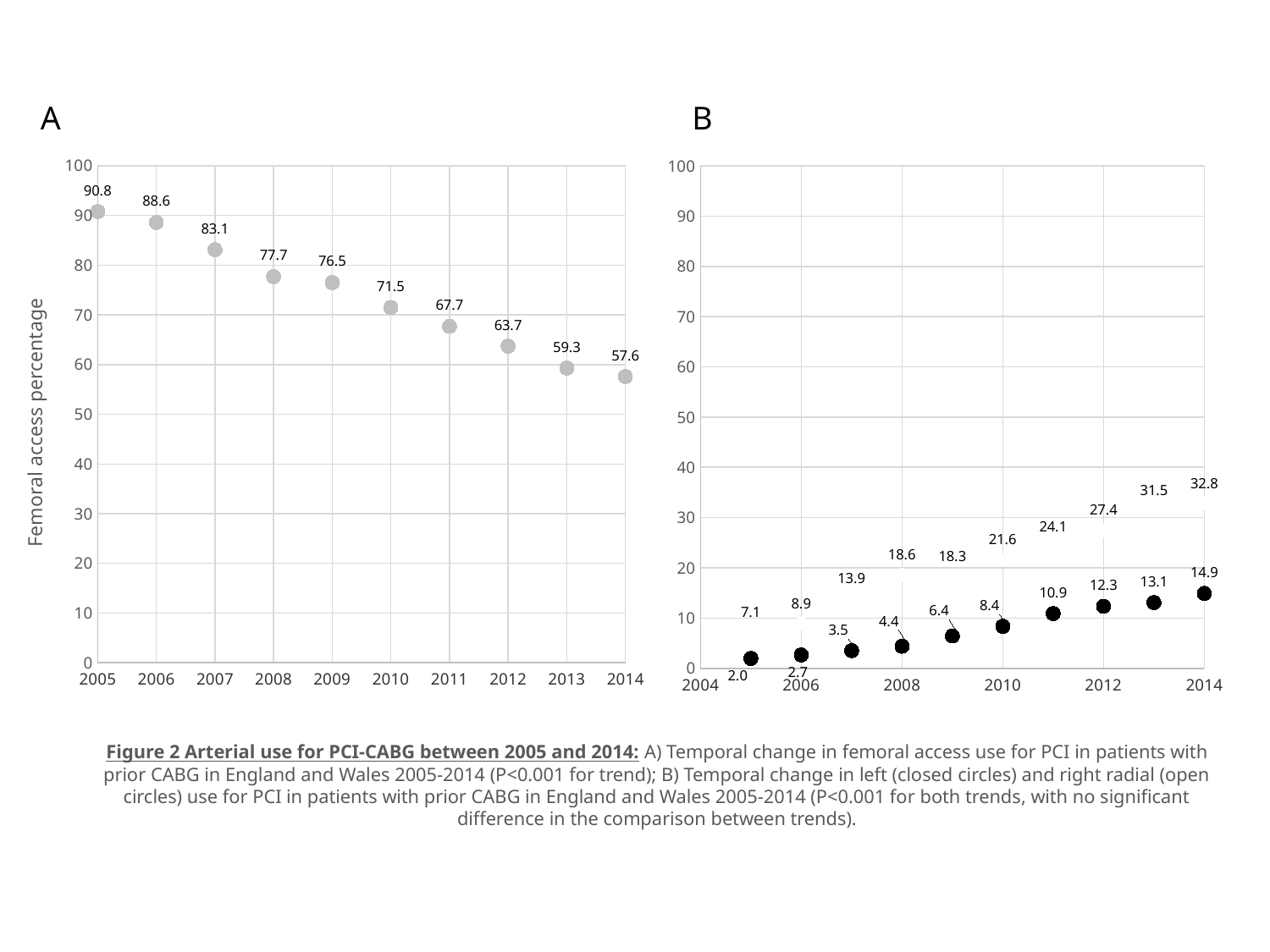
In chart A, what is the femoral access percentage for 2005? 90.8 In chart A, what is the femoral access percentage for 2014? 57.6 In chart B, what is the value of the closed-circle series for 2005? 2.0 In chart B, what is the value of the closed-circle series for 2014? 14.9 In chart B, which closed-circle value is larger, 2009 or 2010? 2010 In chart A, which year has the highest femoral access percentage? 2005 In chart A, do the values rise or fall from 2005 to 2014? fall In chart B, do the closed-circle values rise or fall from 2005 to 2014? rise In chart A, what is the difference between the 2005 value and the 2014 value? 33.2 In chart A, how many years are plotted? 10 In chart A, what is the label on the vertical axis? Femoral access percentage In chart A, which year has the lowest femoral access percentage? 2014